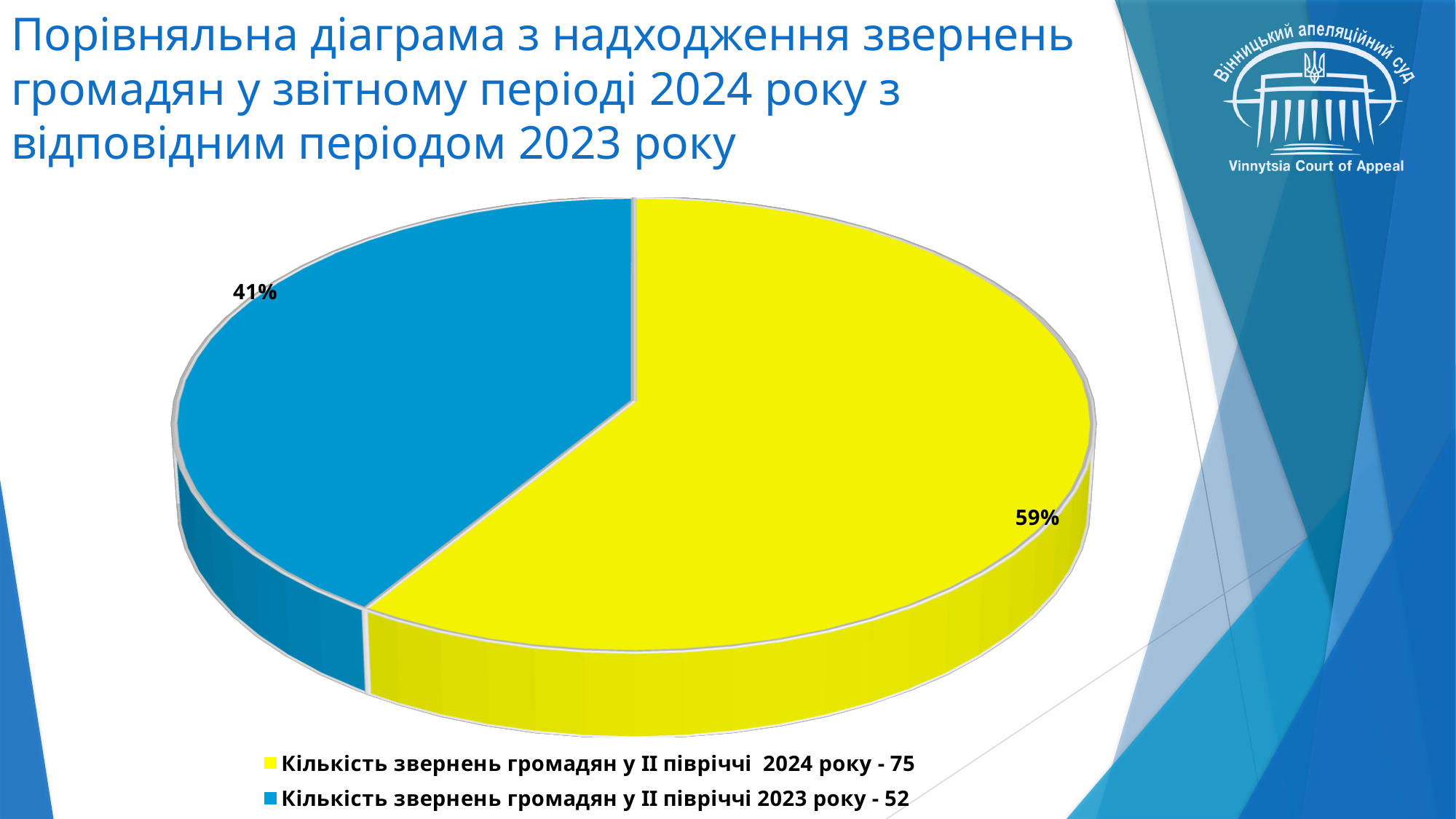
How many slices does the pie chart have? 2 According to the legend, how many citizen appeals were received in the second half of 2023? 52 By how many appeals does the second half of 2024 exceed the second half of 2023, according to the legend values? 23 What is the difference in percentage points between the 2024 slice and the 2023 slice? 18 percentage points How many entries does the legend list? 2 What percentage share is shown for the blue slice (appeals in the second half of 2023)? 41% Which colour represents the appeals received in the second half of 2023? blue What percentage share is shown for the yellow slice (appeals in the second half of 2024)? 59% What kind of chart is shown on the slide? pie chart Which period has the larger slice of the pie, the second half of 2024 or the second half of 2023? second half of 2024 According to the legend, how many citizen appeals were received in the second half of 2024? 75 Which period has the smaller slice of the pie? second half of 2023